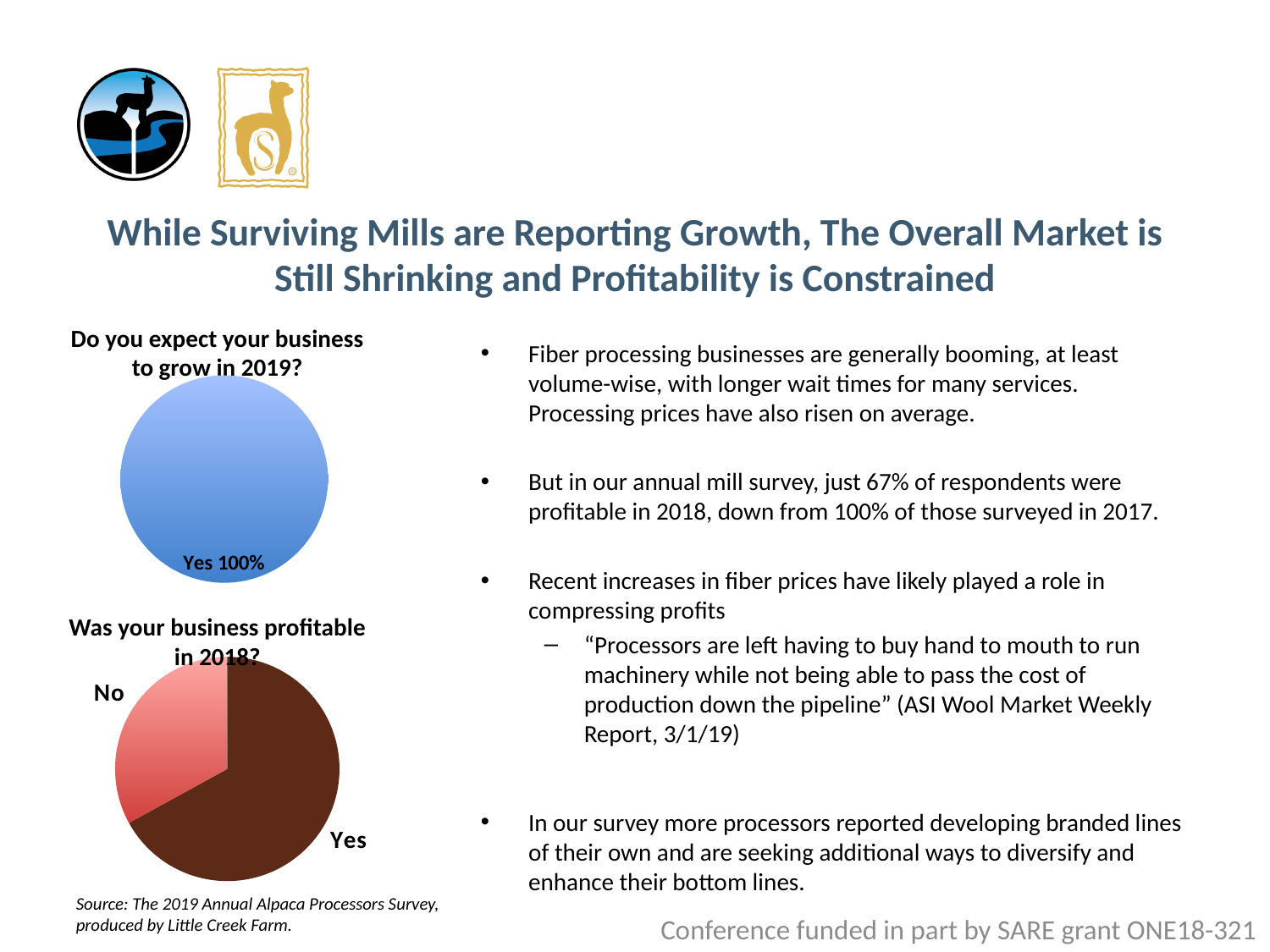
In the top chart "Do you expect your business to grow in 2019?", what share of the pie is labelled Yes? 100% In the bottom chart "Was your business profitable in 2018?", how many slices does the pie have? 2 In the bottom chart "Was your business profitable in 2018?", what colour is the No slice? red In the bottom chart "Was your business profitable in 2018?", which slice is the smallest? No In the top chart "Do you expect your business to grow in 2019?", how many slices does the pie have? 1 What kind of chart is the top chart titled "Do you expect your business to grow in 2019?"? pie chart In the bottom chart "Was your business profitable in 2018?", which slice is larger, Yes or No? Yes What is the title of the top pie chart on the slide? Do you expect your business to grow in 2019? What kind of chart is the bottom chart titled "Was your business profitable in 2018?"? pie chart In the bottom chart "Was your business profitable in 2018?", which slice is the largest? Yes